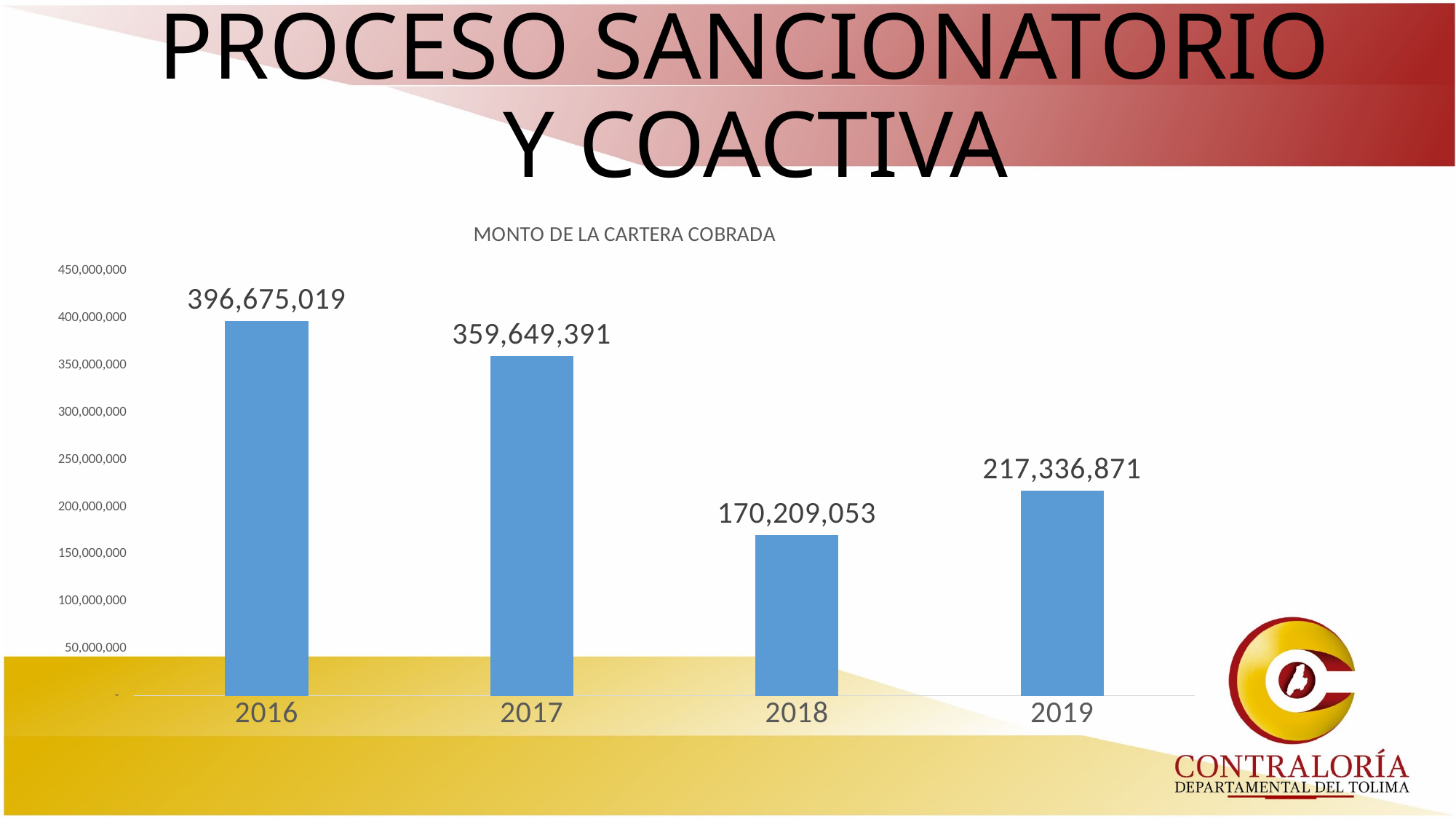
What is the value for 2018? 170,209,053 Which year has the highest value? 2016 Is the value for 2018 greater or less than 200,000,000? less What is the title of the chart? MONTO DE LA CARTERA COBRADA What is the difference between the values for 2019 and 2018? 47,127,818 What kind of chart is shown? bar chart What is the value for 2016? 396,675,019 What is the difference between the values for 2016 and 2017? 37,025,628 Which is larger, the value for 2017 or the value for 2019? 2017 Which year has the lowest value? 2018 How many years are shown on the x axis? 4 What is the value for 2019? 217,336,871